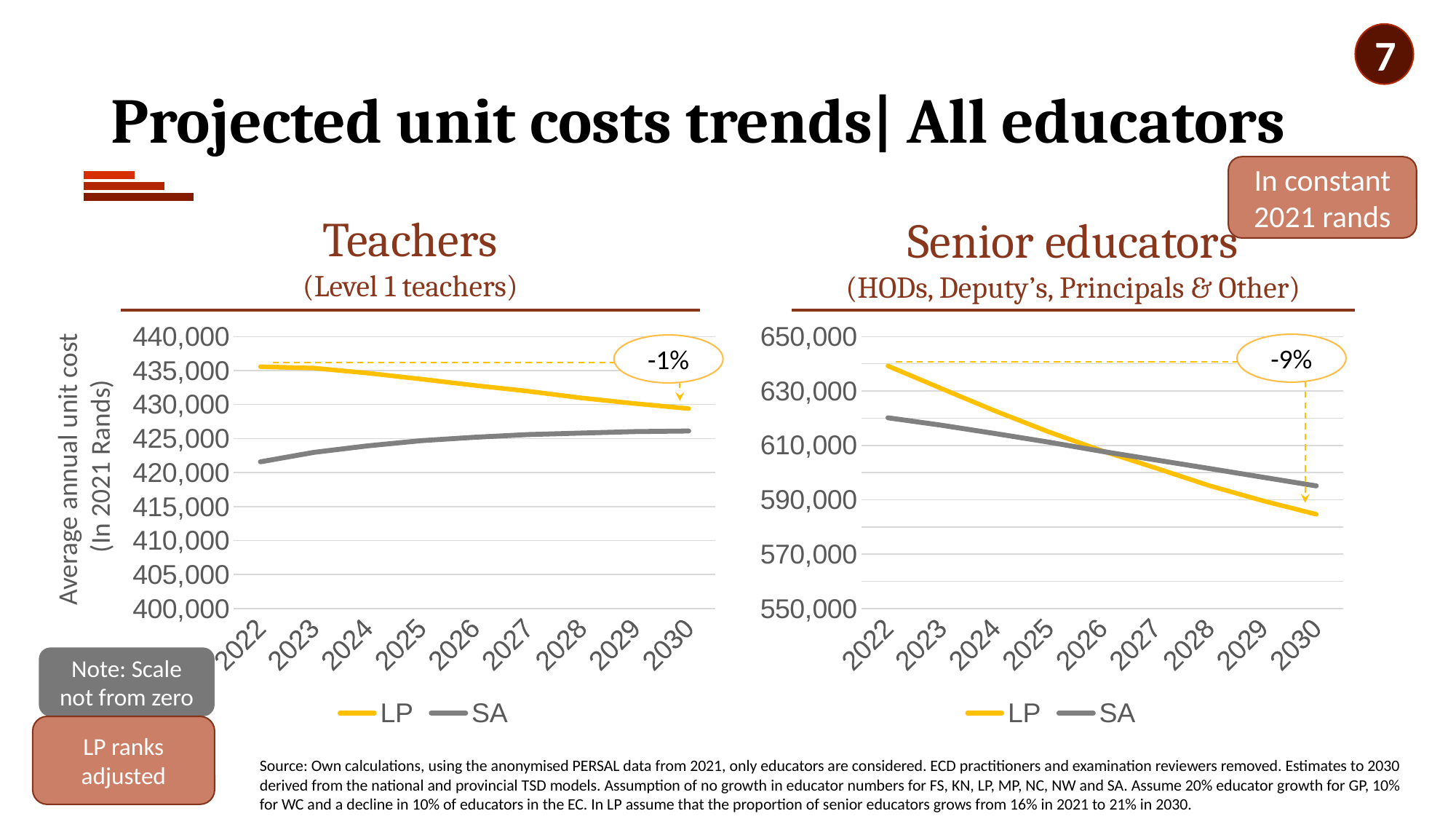
How many years are shown on the x axis of the Teachers (Level 1 teachers) chart? 9 What kind of chart is the Teachers (Level 1 teachers) chart? line chart In the Senior educators chart, is the value for LP in 2030 greater or less than 590,000? less What percentage change is annotated for the LP line in the Senior educators chart? -9% In the Senior educators chart, does the LP line rise or fall from 2022 to 2030? fall How many series does the legend of the Senior educators chart list? 2 In the Teachers (Level 1 teachers) chart, is the value for SA in 2022 greater or less than 425,000? less In the Senior educators chart, is the value for LP in 2022 greater or less than 630,000? greater In the Teachers (Level 1 teachers) chart, which series has the higher value in 2022, LP or SA? LP In the Teachers (Level 1 teachers) chart, does the SA line rise or fall from 2022 to 2030? rise In the Senior educators chart, which series has the higher value in 2030, LP or SA? SA